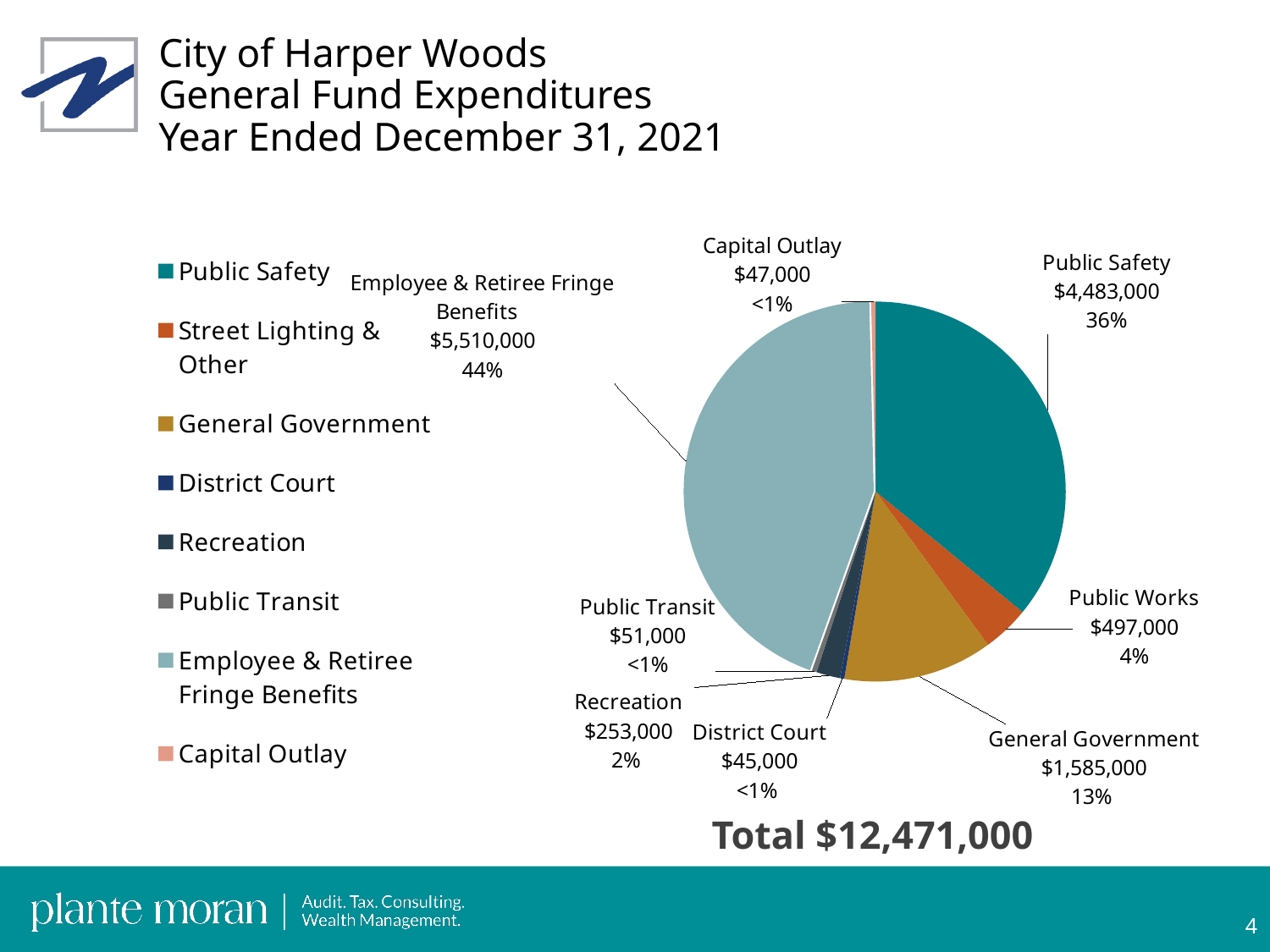
What is the expenditure amount for Public Safety? $4,483,000 Which category has the smallest expenditure amount? District Court What percentage of the pie does General Government represent? 13% What is the difference between the Employee & Retiree Fringe Benefits and Public Safety expenditures? $1,027,000 What type of chart is shown on the slide? pie chart What percentage of the pie does Employee & Retiree Fringe Benefits represent? 44% What is the difference between the Public Safety and General Government expenditures? $2,898,000 What is the expenditure amount for Recreation? $253,000 Which is larger, the expenditure for Recreation or for Public Transit? Recreation How many slices does the pie chart have? 8 Which category has the largest expenditure? Employee & Retiree Fringe Benefits What is the total of General Fund Expenditures shown on the slide? $12,471,000